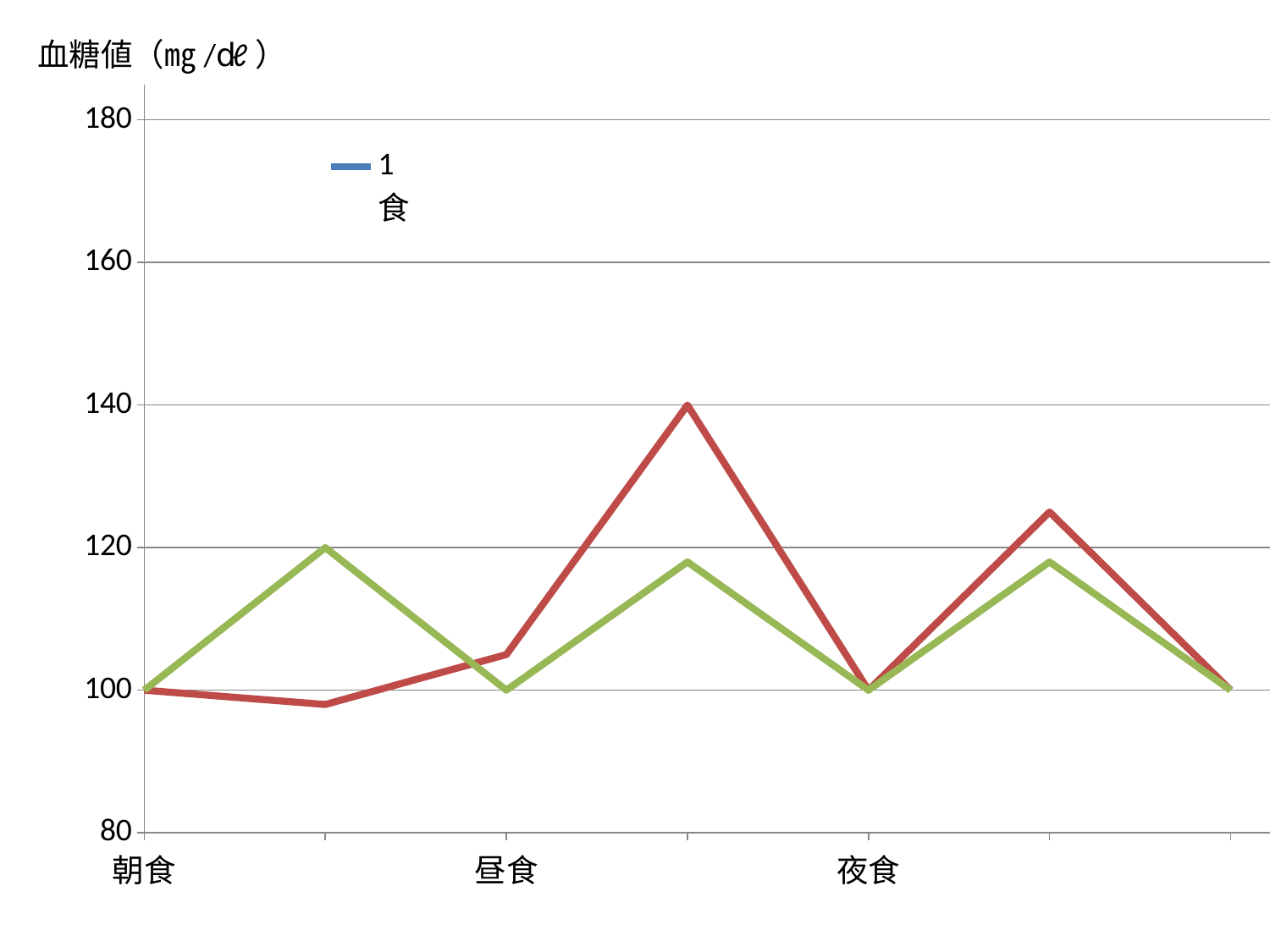
Between 朝食 and 昼食, which line reaches a higher peak, the red line or the green line? the green line Is the value of the red line at 昼食 greater or less than 120? less How many meal categories are labeled on the x axis of the chart? 3 Between 昼食 and 夜食, which line reaches a higher peak, the red line or the green line? the red line Does the red line rise or fall from 昼食 to the next point on the x axis? rise What is the value of the green line at 夜食? 100 What is the highest value reached by the red line? 140 What is the highest value reached by the green line? 120 Is the peak of the red line between 昼食 and 夜食 greater or less than 120? greater What is the title of the vertical axis on the chart? 血糖値（mg/dℓ） What kind of chart is shown on the slide? line chart What is the value of the red line at 朝食? 100